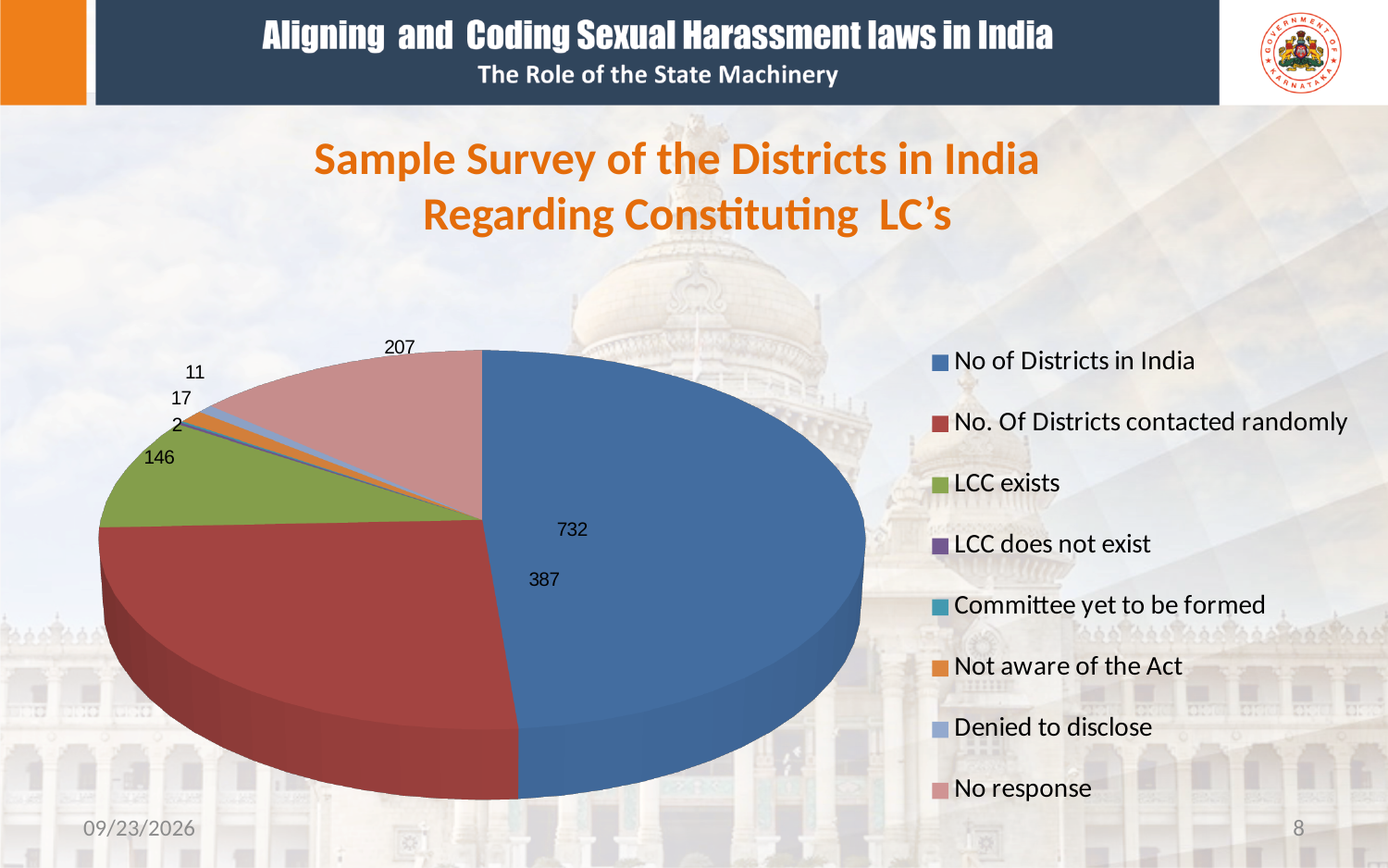
What is the difference between No of Districts in India and No. Of Districts contacted randomly? 345 What kind of chart is shown on the slide? pie chart Which is larger, LCC exists or No response? No response What is the value for No response? 207 What colour is the slice for No of Districts in India? blue Which category has the largest slice of the pie? No of Districts in India What is the value for No. Of Districts contacted randomly? 387 How many categories does the legend list? 8 What is the title shown above the chart? Sample Survey of the Districts in India Regarding Constituting LC's What is the value for LCC exists? 146 What is the difference between No response and LCC exists? 61 What is the value for No of Districts in India? 732